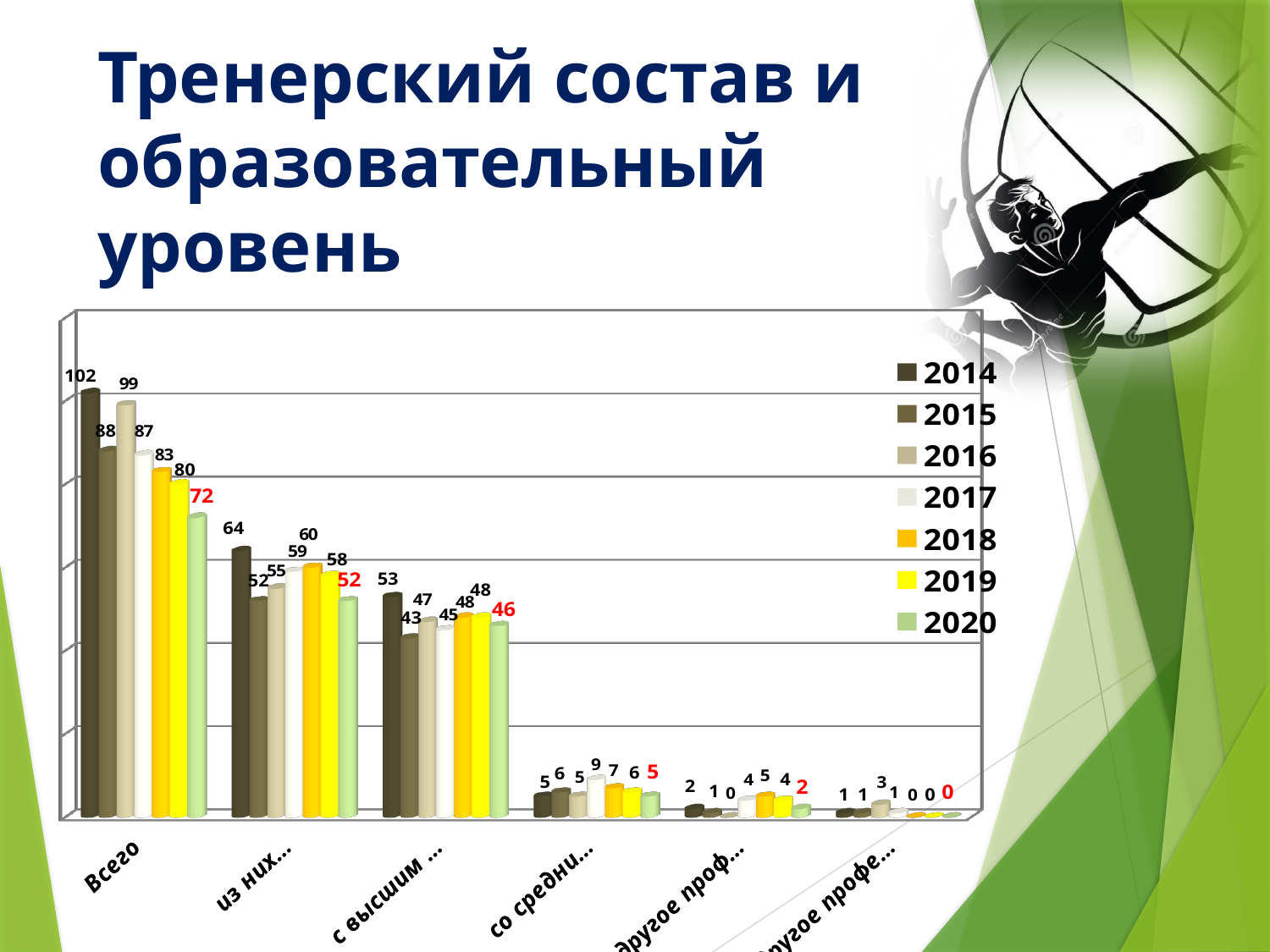
In the "Всего" category, which year has the larger value, 2015 or 2016? 2016 What is the value for 2014 in the "Всего" category? 102 What kind of chart is shown on the slide? bar chart What is the value for 2020 in the "Всего" category? 72 What is the difference between the 2014 and 2020 values in the "Всего" category? 30 How many series does the legend list? 7 What is the value for 2016 in the "Всего" category? 99 Which year has the highest value in the "Всего" category? 2014 Which year has the lowest value in the "Всего" category? 2020 In the "Всего" category, do the values rise or fall from 2016 to 2020? fall How many categories are shown on the x axis? 6 What colour represents the 2019 series in the legend? yellow